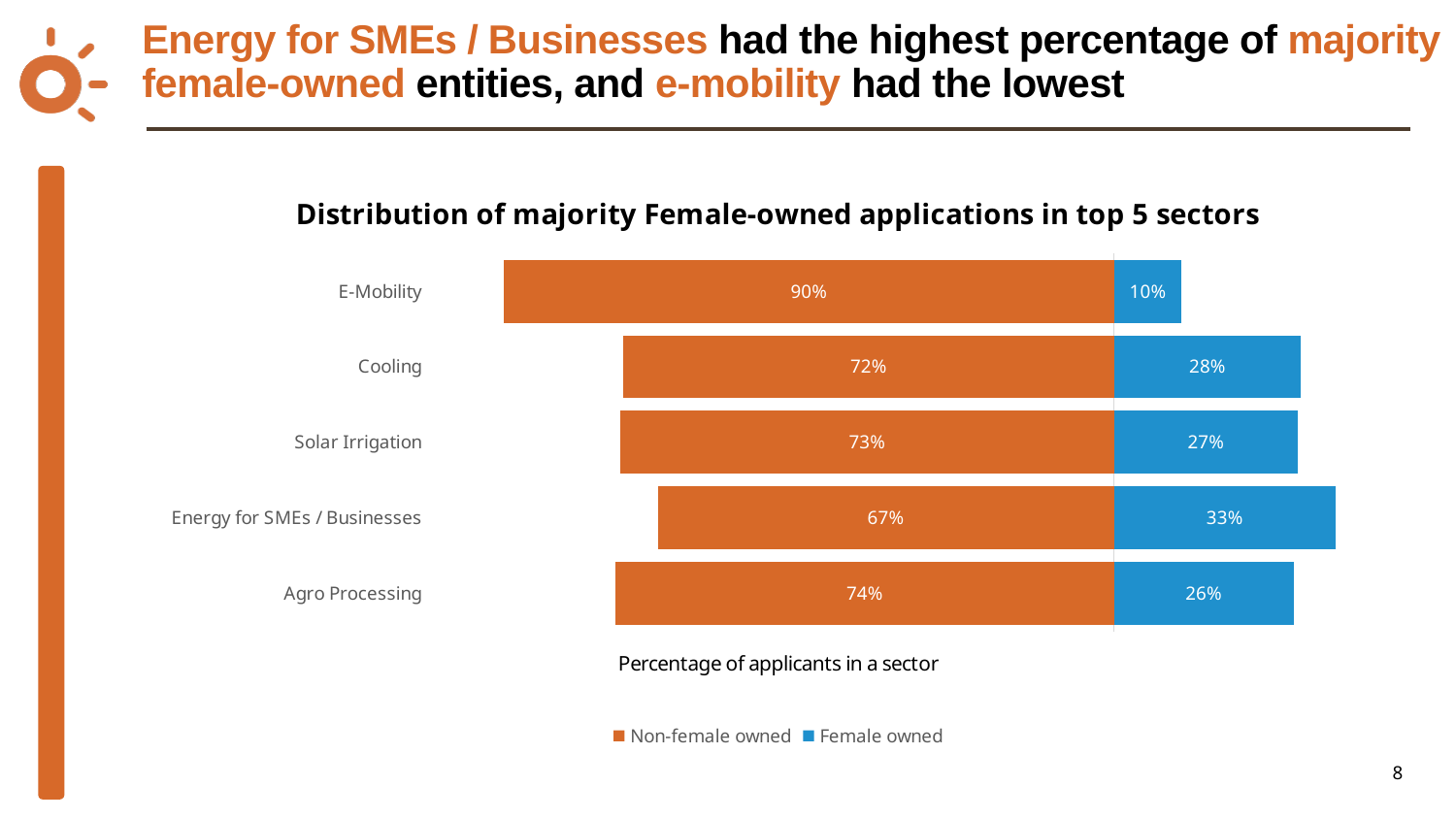
What is the Female owned percentage for E-Mobility? 10% Which sector has the highest Female owned percentage? Energy for SMEs / Businesses What is the Non-female owned percentage for Cooling? 72% What is the title of the chart? Distribution of majority Female-owned applications in top 5 sectors What kind of chart is shown on the slide? Bar chart What is the Non-female owned percentage for Agro Processing? 74% How many sectors are shown in the chart? 5 What is the Female owned percentage for Energy for SMEs / Businesses? 33% How many series does the legend list? 2 Which is larger, the Non-female owned percentage for Solar Irrigation or for Energy for SMEs / Businesses? Solar Irrigation What is the difference between the Female owned percentages for Cooling and E-Mobility? 18% Which sector has the lowest Female owned percentage? E-Mobility